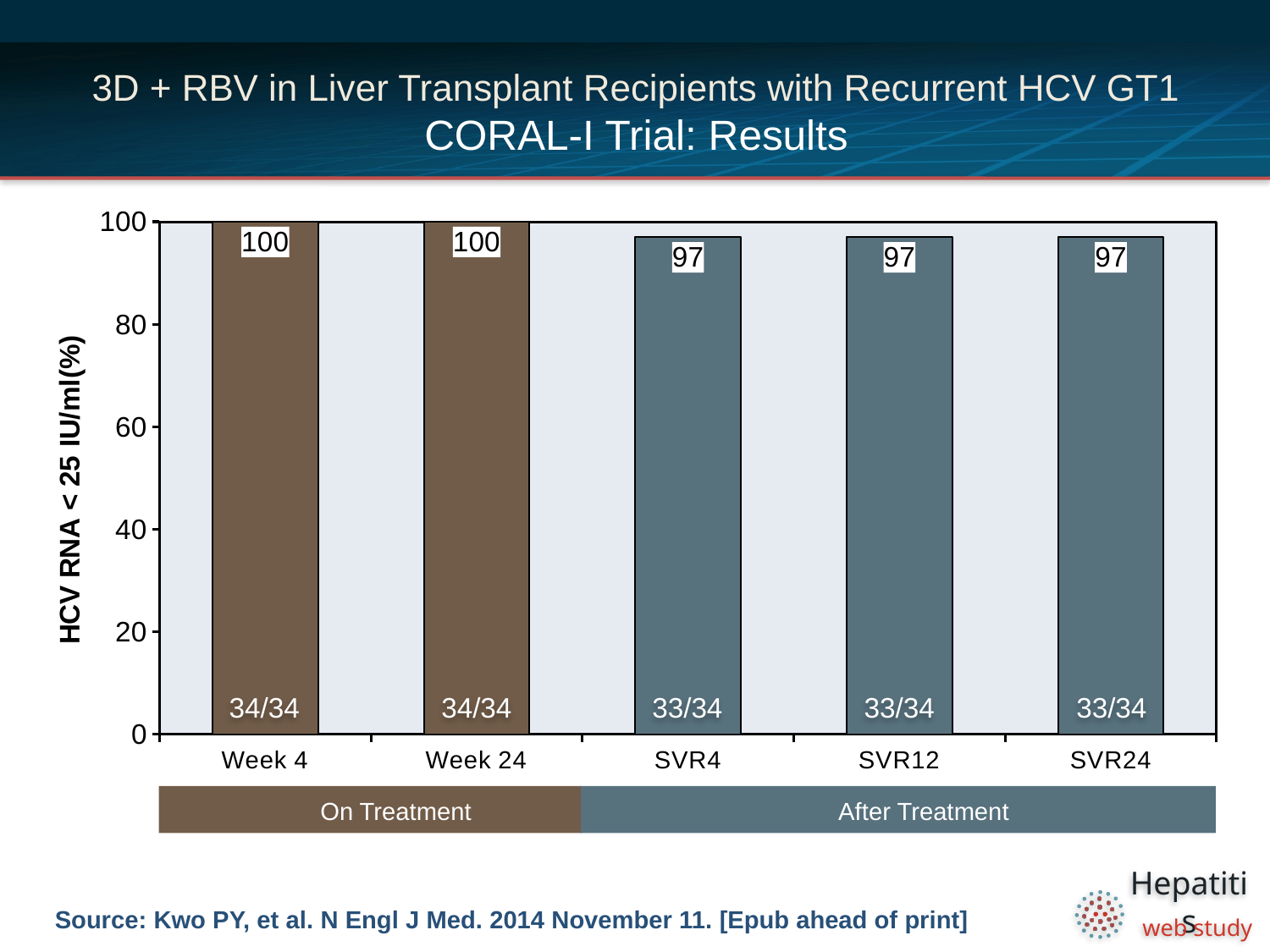
Which is larger, the value for Week 4 or the value for SVR24? Week 4 What is the difference between the values for Week 24 and SVR12? 3 What fraction of patients is shown inside the Week 24 bar? 34/34 How many bars are plotted in the chart? 5 What is the value for Week 4? 100 What is the value for SVR12? 97 Is the value for SVR4 greater or less than 80? greater What kind of chart is shown on the slide? Bar chart What is the value for SVR24? 97 What is the label of the y axis? HCV RNA < 25 IU/ml(%) Which time points are grouped under the 'After Treatment' band below the x axis? SVR4, SVR12, SVR24 What fraction of patients is shown inside the SVR4 bar? 33/34